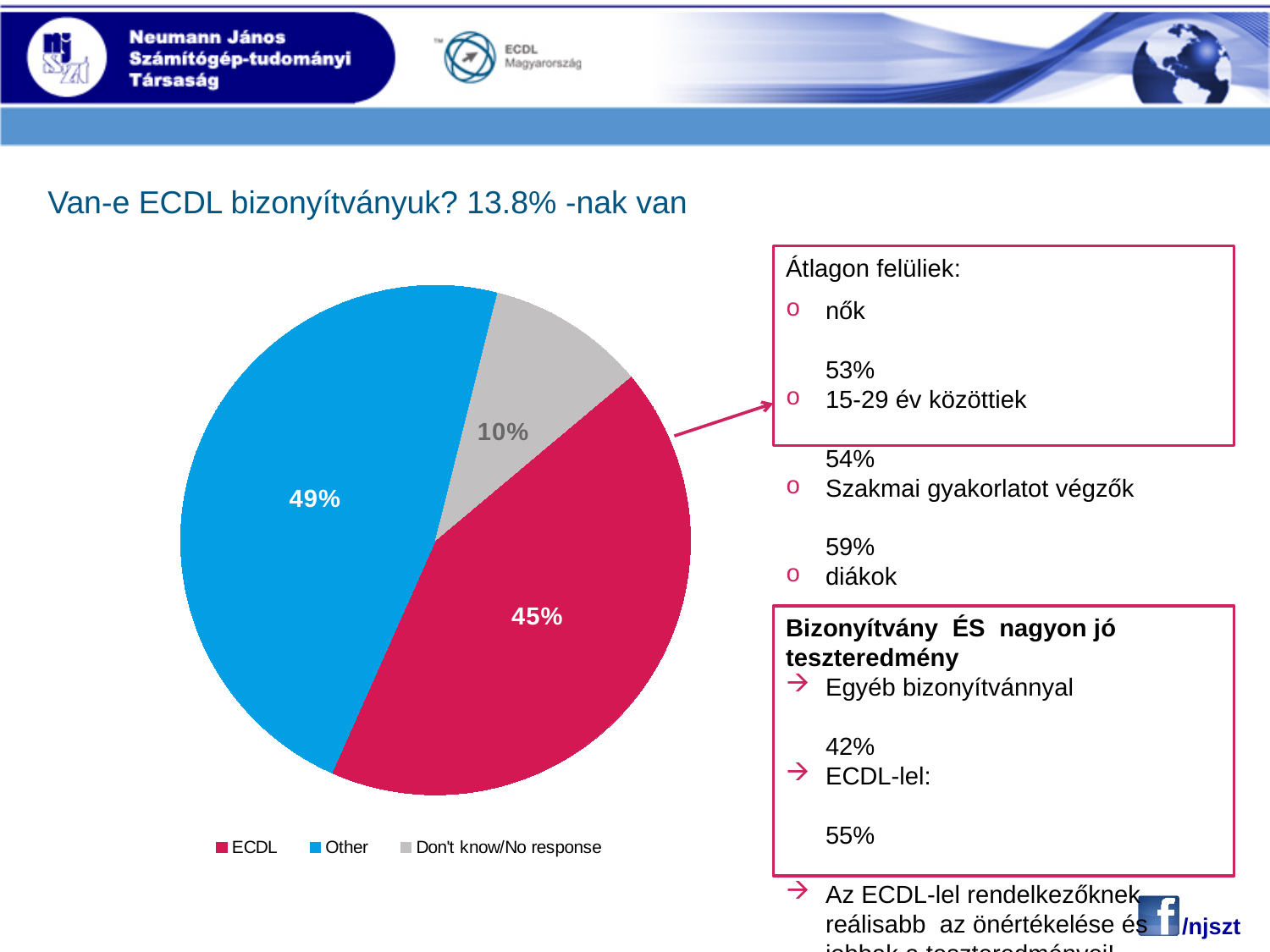
How many slices does the pie chart have? 3 What share of the pie does the ECDL slice have? 45% What is the difference in percentage points between the ECDL slice and the Don't know/No response slice? 35% What colour is the Other slice in the pie chart? blue What kind of chart is shown on the slide? pie chart Which slice of the pie is the smallest? Don't know/No response How many entries does the legend of the pie chart list? 3 Which is larger, the ECDL slice or the Don't know/No response slice? ECDL What is the difference in percentage points between the Other slice and the ECDL slice? 4% What share of the pie does the Other slice have? 49% Which slice of the pie is the largest? Other What share of the pie does the Don't know/No response slice have? 10%